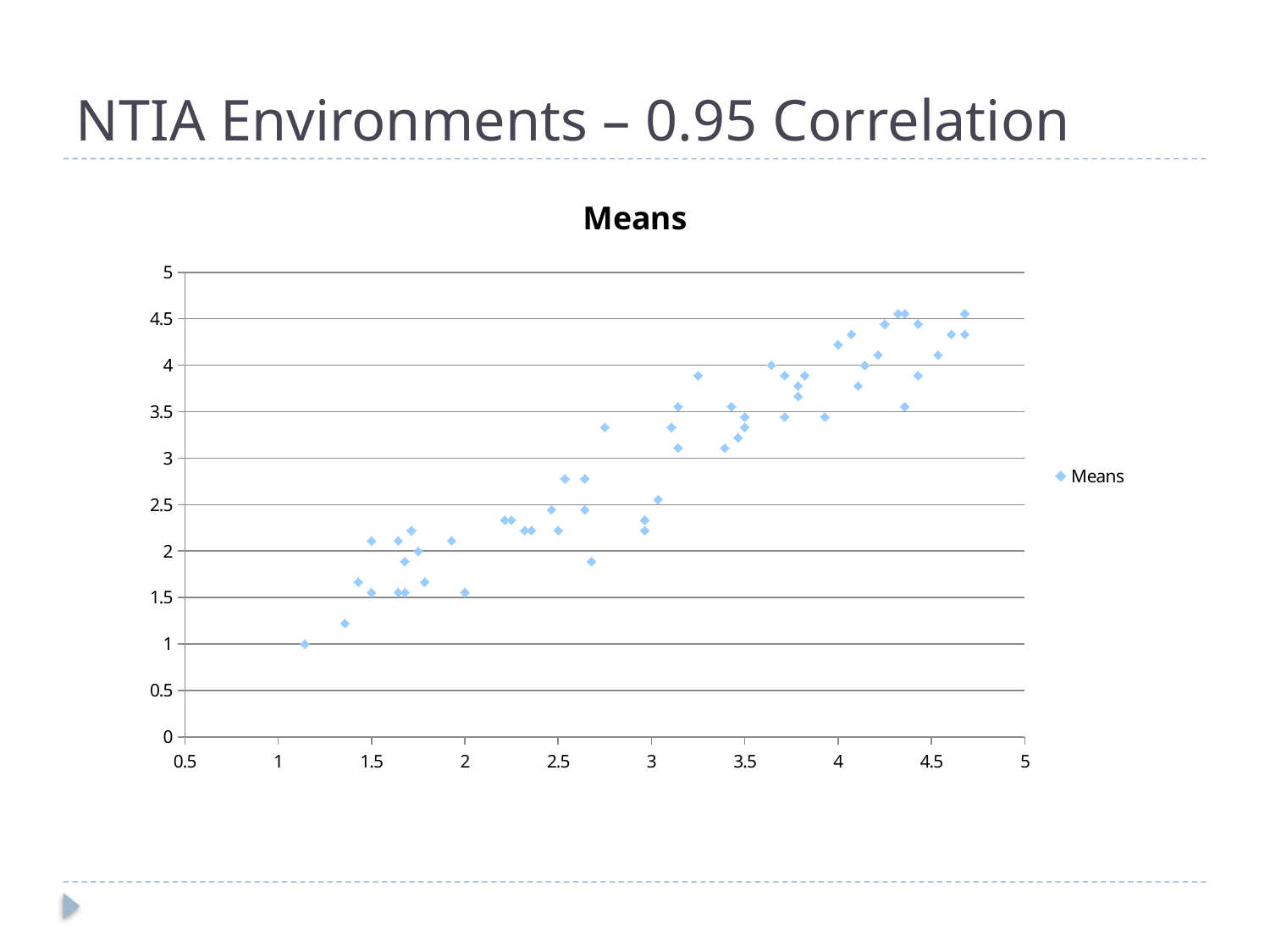
Is the highest plotted y value greater or less than 5? less What is the title of the chart? Means Is the lowest plotted y value greater or less than 1.5? less What is the lowest y value plotted on the chart? 1 What is the name of the series shown in the legend? Means How many series does the legend list? 1 What kind of chart is shown on the slide? Scatter chart Is the highest plotted y value greater or less than 4? greater Do the plotted y values generally rise or fall as the x value increases? Rise